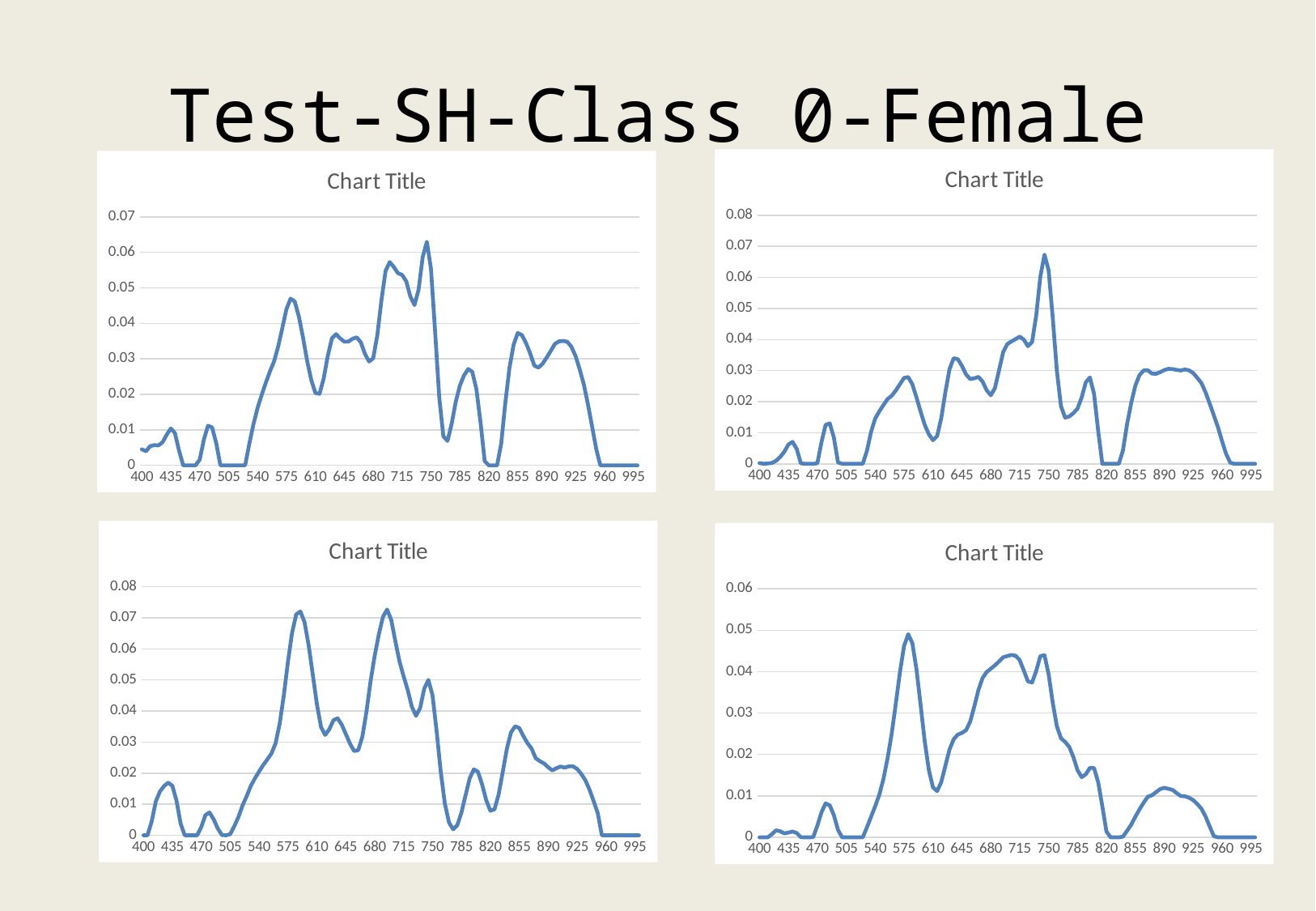
In the bottom-right chart, is the value at 995 greater or less than 0.01? less What is the highest value labelled on the y axis of the bottom-right chart? 0.06 In the bottom-right chart, do the values rise or fall between 890 and 960 on the x axis? fall In the top-right chart, is the value at 610 greater or less than 0.01? less In the top-left chart, do the values rise or fall between 505 and 575 on the x axis? rise In the top-right chart, is the value at 750 greater or less than 0.06? greater What kind of chart is the top-left chart? line chart